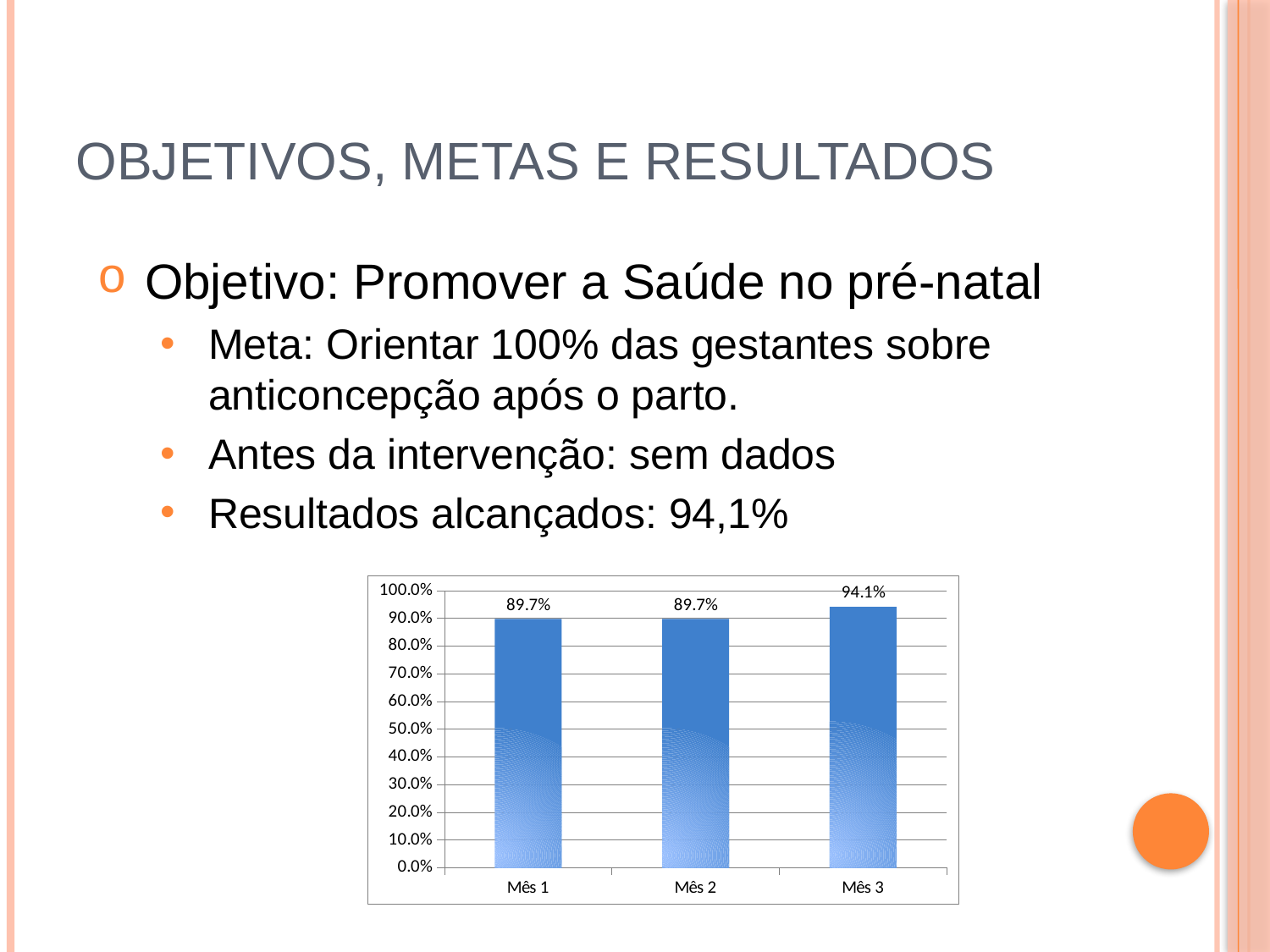
How many months are shown on the x axis? 3 Do the values rise or fall from Mês 2 to Mês 3? Rise Do Mês 1 and Mês 2 have the same value? Yes Is the value for Mês 3 larger than the value for Mês 1? Yes What kind of chart is shown on the slide? Bar chart What is the maximum value shown on the y axis? 100.0% Which month has the highest value? Mês 3 What is the value for Mês 1? 89.7% Is the value for Mês 2 greater or less than 80.0%? greater What is the value for Mês 3? 94.1% What is the difference between the values for Mês 3 and Mês 2? 4.4% What colour are the bars in the chart? Blue